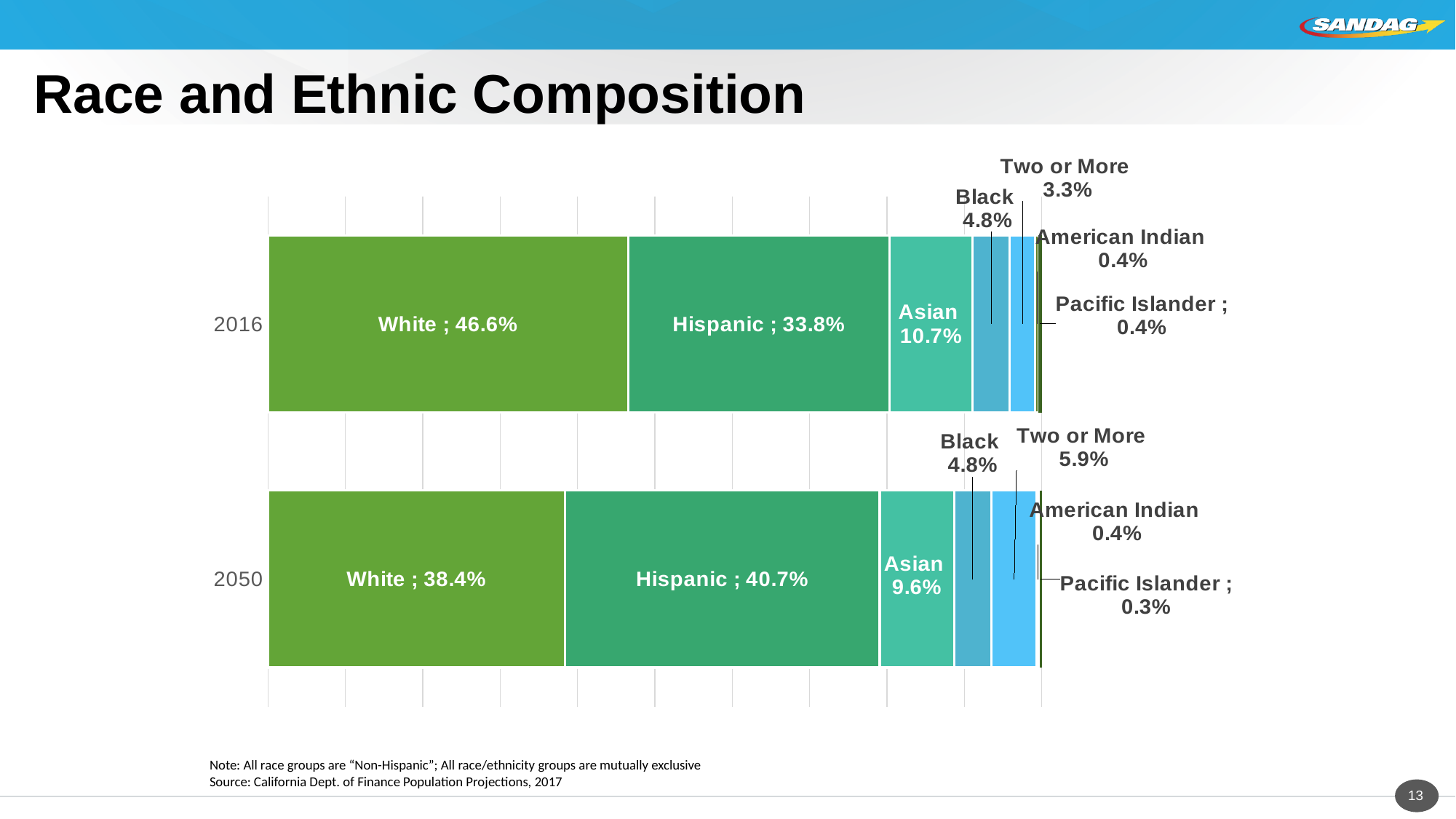
What is the Pacific Islander share in 2050? 0.3% How much larger is the White share than the Hispanic share in 2016? 12.8 percentage points How many years (bars) are shown in the chart? 2 What share of the population is Hispanic in 2050? 40.7% Which group has the largest share in 2050? Hispanic What share of the population is White in 2016? 46.6% What kind of chart is shown on the slide? Stacked bar chart Which is larger in 2050, the White share or the Hispanic share? Hispanic By how much does the Two or More share change from 2016 to 2050? 2.6 percentage points What is the Two or More share in 2016? 3.3% Which group has the largest share in 2016? White What is the Asian share in 2050? 9.6%